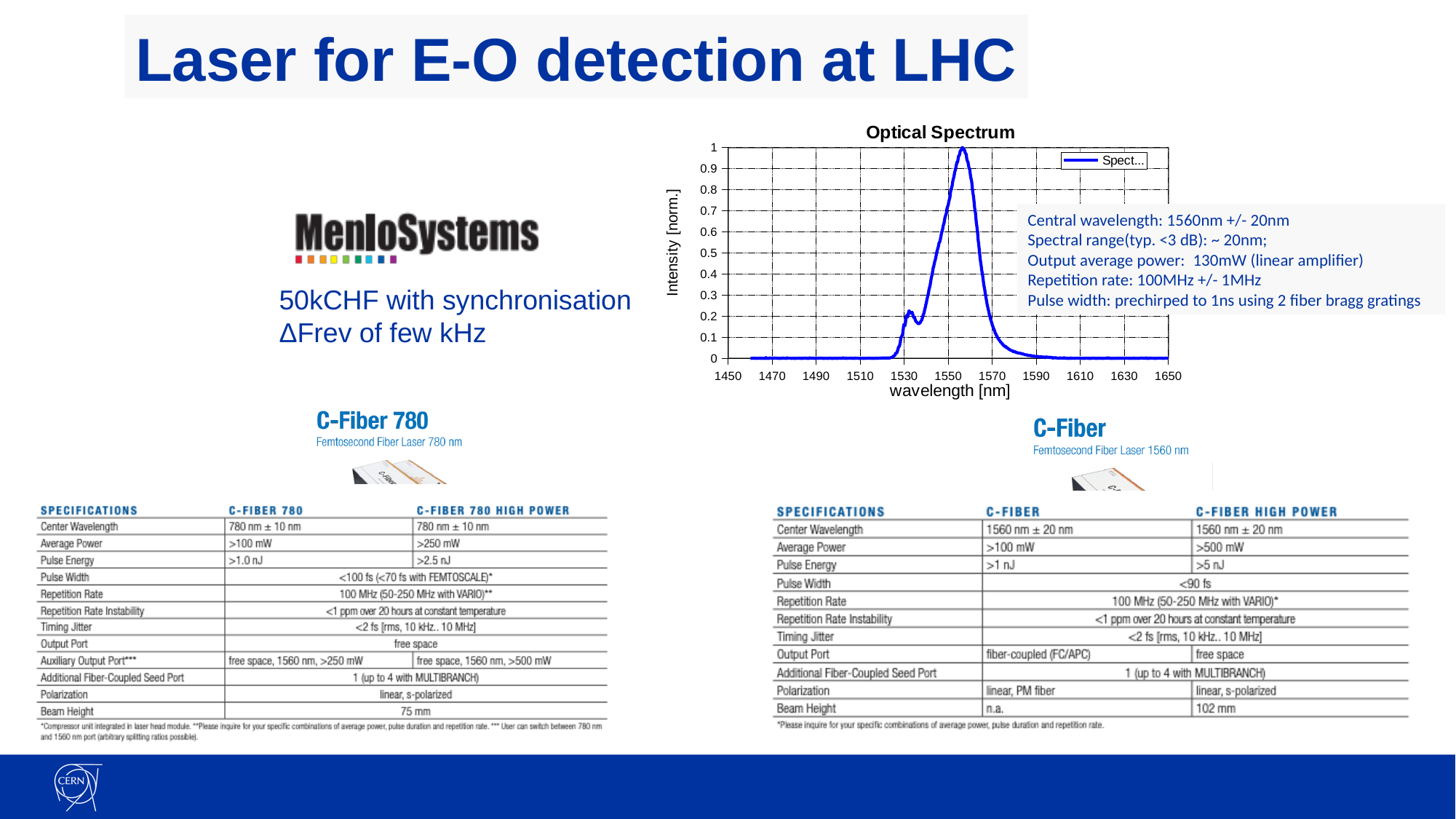
In the Optical Spectrum chart, is the intensity at 1570 nm greater or less than 0.5? less In the Optical Spectrum chart, is the peak intensity greater or less than 0.9? greater What is the title of the chart on the slide? Optical Spectrum How many series does the legend of the Optical Spectrum chart list? 1 In the Optical Spectrum chart, is the intensity at 1530 nm greater or less than 0.5? less In the Optical Spectrum chart, does the intensity rise or fall between 1560 nm and 1580 nm? fall What is the label of the x axis of the Optical Spectrum chart? wavelength [nm] What kind of chart is the Optical Spectrum chart? line chart In the Optical Spectrum chart, which wavelength has the higher intensity, 1530 nm or 1560 nm? 1560 nm In the Optical Spectrum chart, does the intensity rise or fall between 1540 nm and 1555 nm? rise